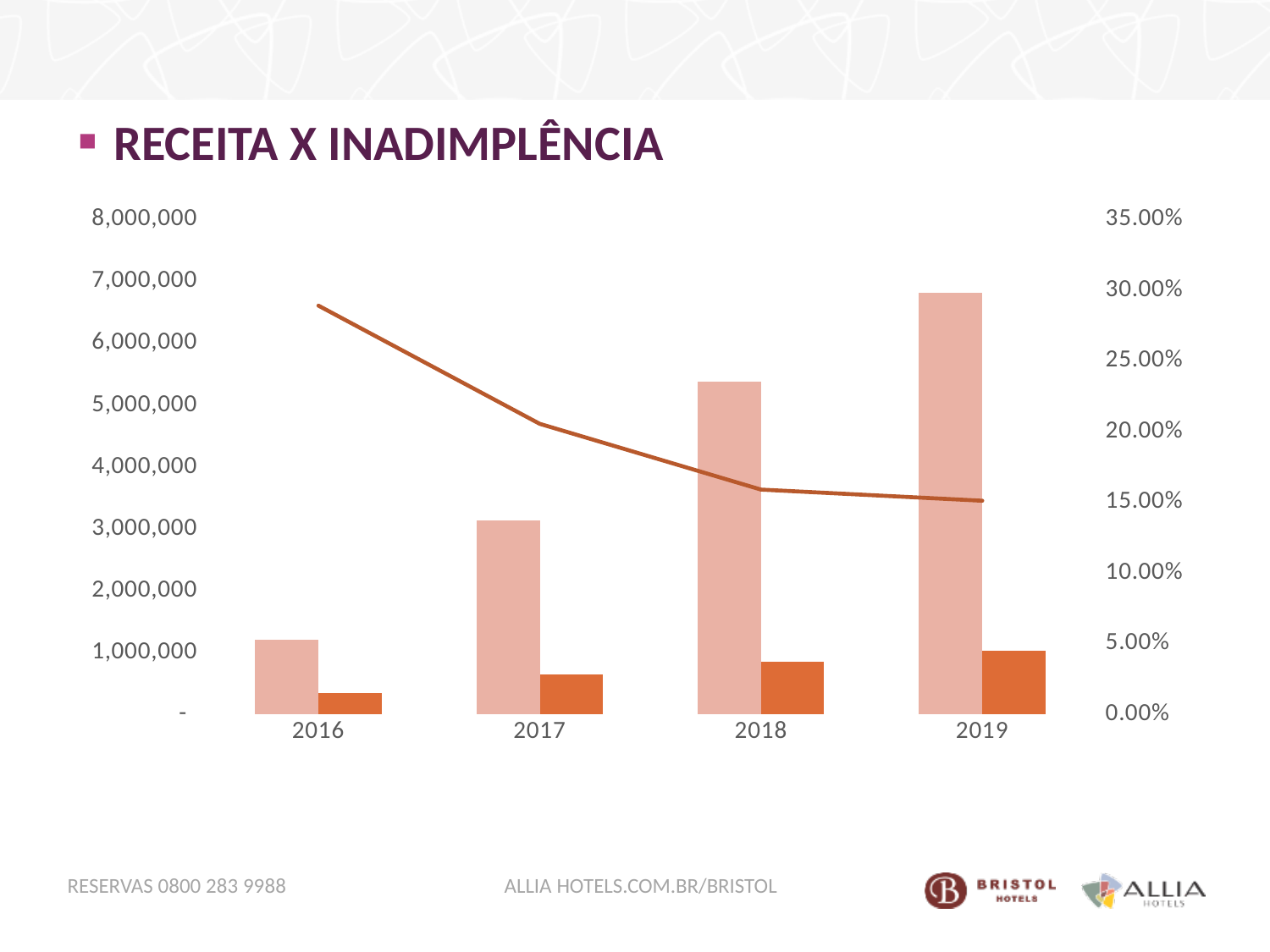
Which year has the shortest light pink bar? 2016 Does the line rise or fall from 2016 to 2019? Fall Which year has the shortest dark orange bar? 2016 How many years are shown on the x axis of the chart? 4 Is the line value for 2016 greater or less than 25.00%? greater Which year has the tallest light pink bar? 2019 Is the dark orange bar for 2016 greater or less than 1,000,000? less What is the title of the chart? RECEITA X INADIMPLÊNCIA Is the light pink bar for 2018 larger or smaller than the light pink bar for 2017? Larger Do the light pink bars rise or fall from 2016 to 2019? Rise What kind of chart is shown on the slide? A combination bar and line chart Is the light pink bar for 2019 greater or less than 6,000,000? greater